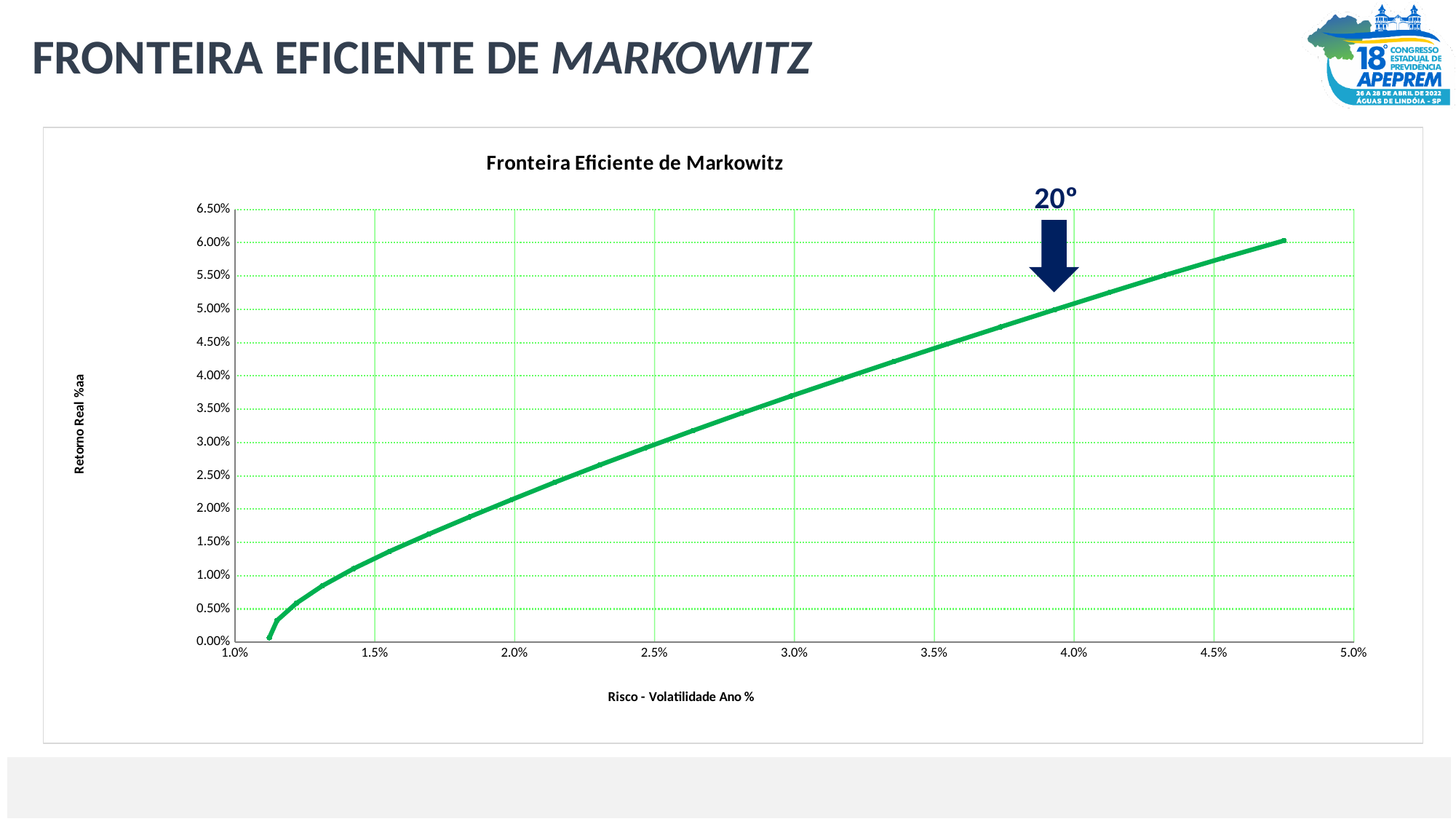
Is the return at a risk of 1.5% greater or less than 1.50%? less Is the return at a risk of 4.5% greater or less than 5.50%? greater Is the highest return value reached by the curve greater or less than 6.50%? less What is the title of the chart? Fronteira Eficiente de Markowitz Does the return (Retorno Real %aa) rise or fall as risk increases along the x axis? rise What kind of chart is shown on the slide? line chart What is the label of the horizontal axis of the chart? Risco - Volatilidade Ano %